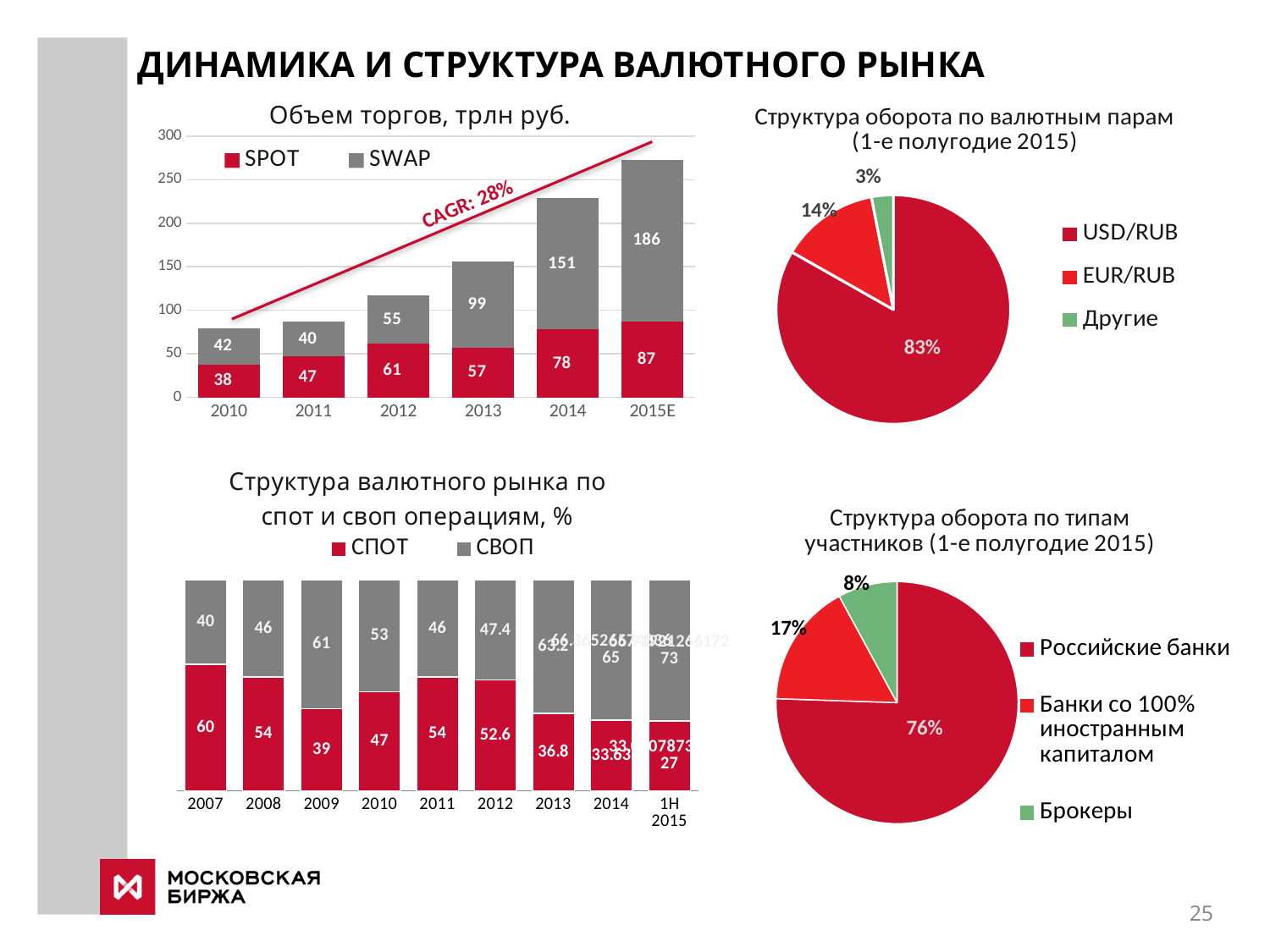
In the pie chart 'Структура оборота по валютным парам (1-е полугодие 2015)', which currency pair has the largest share? USD/RUB In the chart 'Структура валютного рынка по спот и своп операциям, %', what is the СПОТ value for 2009? 39 In the chart 'Объем торгов, трлн руб.', what is the SWAP value for 2014? 151 In the chart 'Структура валютного рынка по спот и своп операциям, %', how many series does the legend list? 2 In the pie chart 'Структура оборота по типам участников (1-е полугодие 2015)', what share do Брокеры have? 8% In the chart 'Объем торгов, трлн руб.', what is the difference between the SWAP and SPOT values for 2013? 42 In the chart 'Объем торгов, трлн руб.', what is the SPOT value for 2012? 61 In the chart 'Объем торгов, трлн руб.', which year has the lowest SPOT value? 2010 In the chart 'Объем торгов, трлн руб.', what is the total of the stacked bar for 2015E? 273 In the chart 'Объем торгов, трлн руб.', what CAGR is shown on the trend line? CAGR: 28% In the pie chart 'Структура оборота по валютным парам (1-е полугодие 2015)', what share does EUR/RUB have? 14%